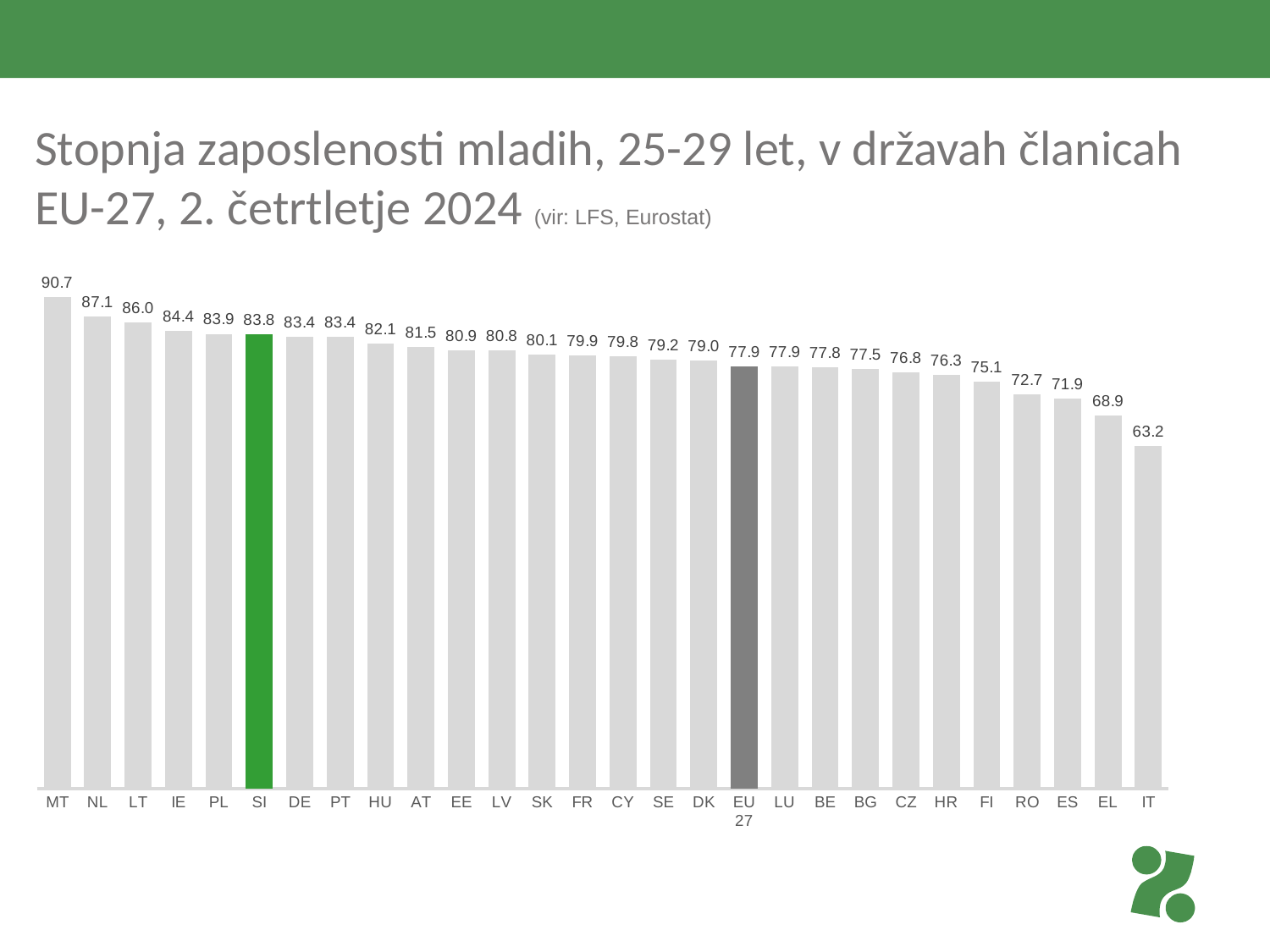
How many bars are shown in the chart? 28 Do the values rise or fall from left to right along the x axis? Fall What is the value for EU 27? 77.9 Which is larger, the value for NL or the value for ES? NL Which bar is coloured green? SI What is the value for SI? 83.8 Which country has the lowest value? IT What kind of chart is shown on the slide? Bar chart Which country has the highest value? MT What is the difference between the values for MT and IT? 27.5 What is the difference between the values for SI and EU 27? 5.9 What is the value for IT? 63.2